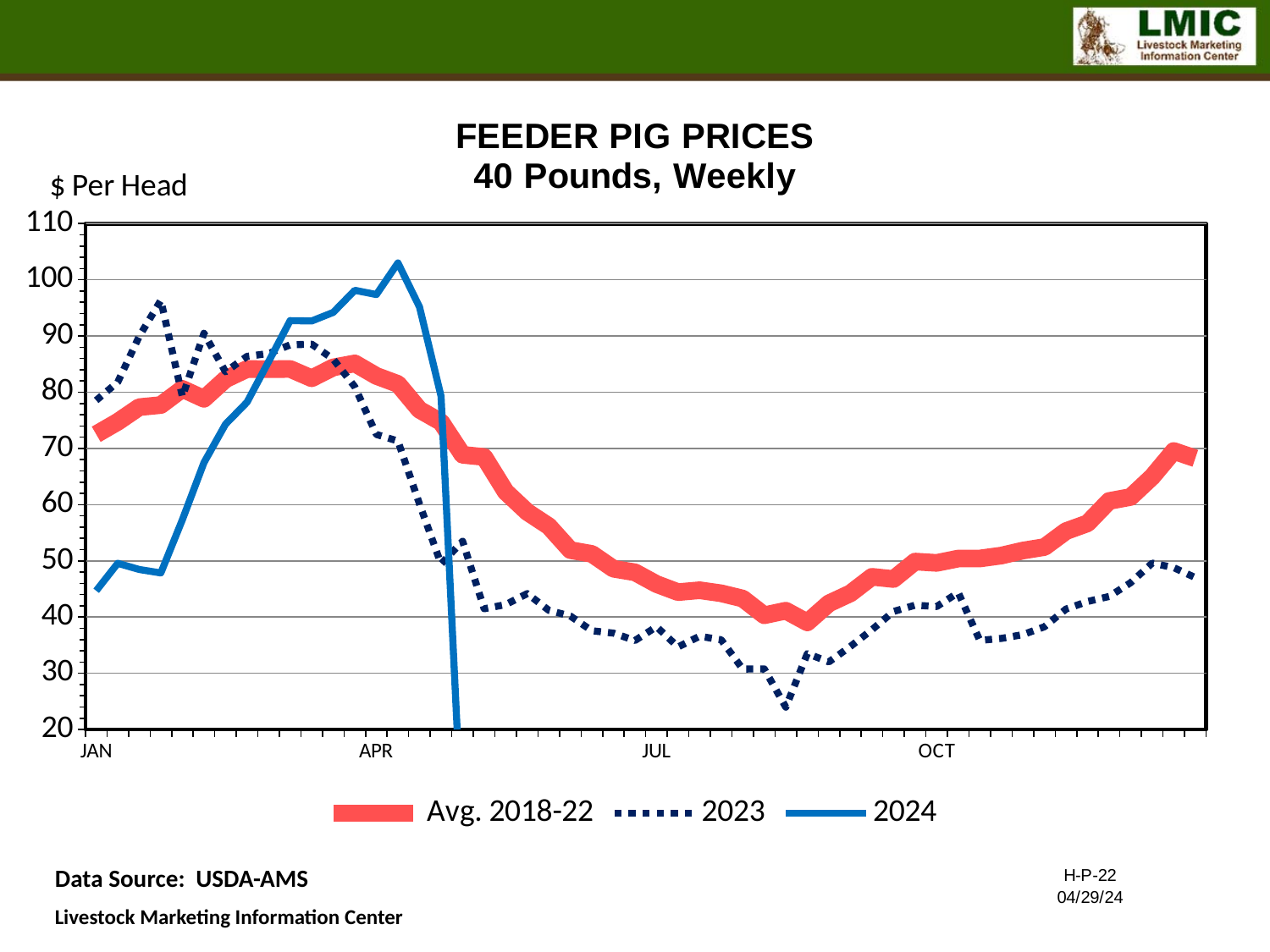
Is the peak value of the 2024 series greater or less than 100? greater Is the value of the Avg. 2018-22 series at the start of January greater or less than 70? greater What kind of chart is shown on the slide? line chart Is the lowest value of the 2023 series greater or less than 30? less What is the title of the chart? FEEDER PIG PRICES 40 Pounds, Weekly Does the Avg. 2018-22 series rise or fall from April to September? fall What unit label is shown on the vertical axis? $ Per Head Does the 2024 series rise or fall from January to April? rise How many series does the legend list? 3 At the start of January, which series is higher: 2023 or 2024? 2023